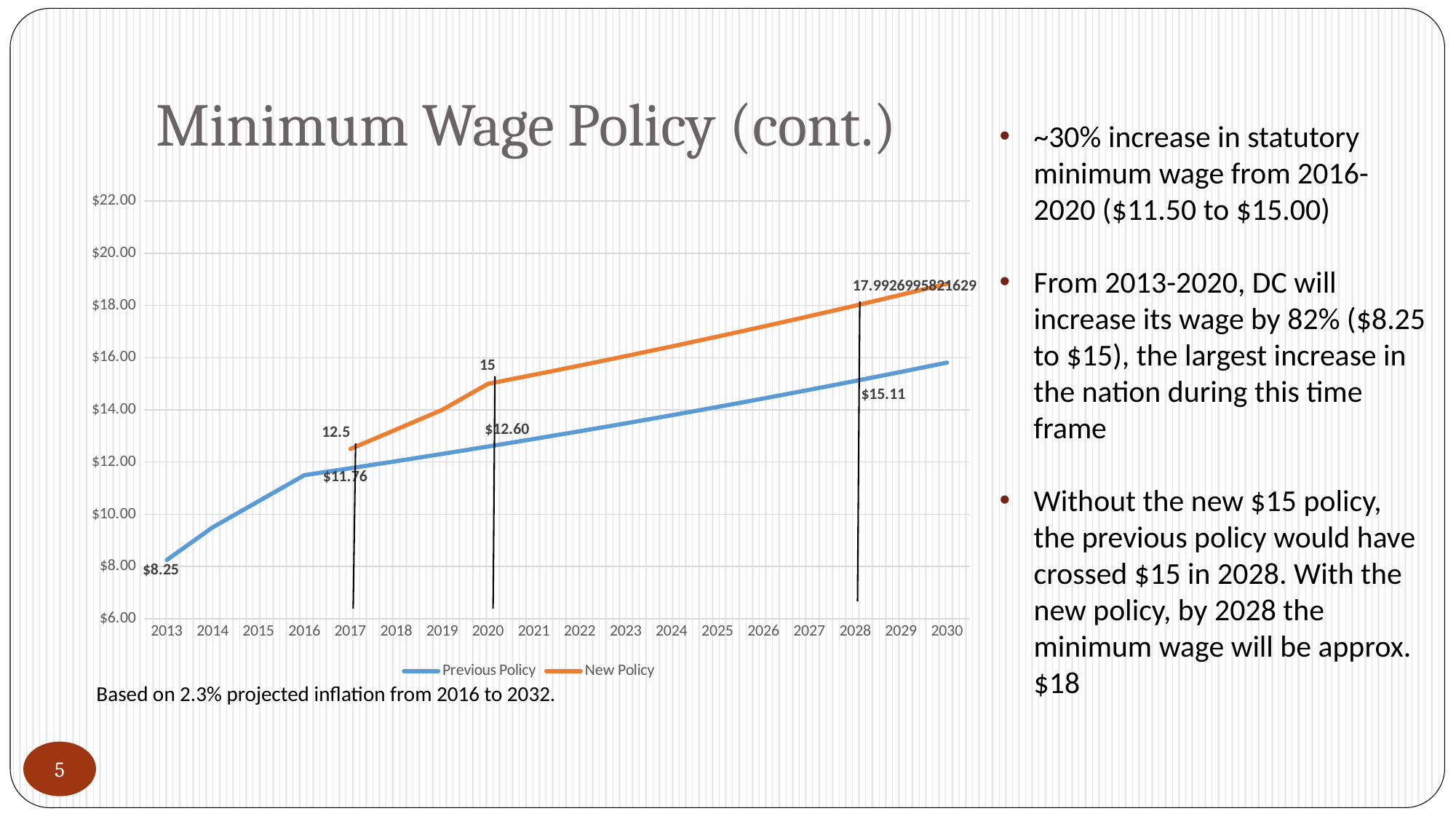
What are the two series named in the chart legend? Previous Policy and New Policy What kind of chart is shown on the slide? line chart Is the value of the New Policy line in 2030 greater or less than $18.00? greater What is the labelled value of the Previous Policy line in 2013? $8.25 Which series is higher in 2028, Previous Policy or New Policy? New Policy How many years are shown along the x axis of the chart? 18 What is the labelled value of the Previous Policy line in 2017? $11.76 Is the value of the Previous Policy line in 2016 greater or less than $12.00? less What is the labelled value of the New Policy line in 2020? 15 Does the Previous Policy line rise or fall from 2013 to 2030? rise How many series does the chart legend list? 2 What is the labelled value of the Previous Policy line in 2028? $15.11